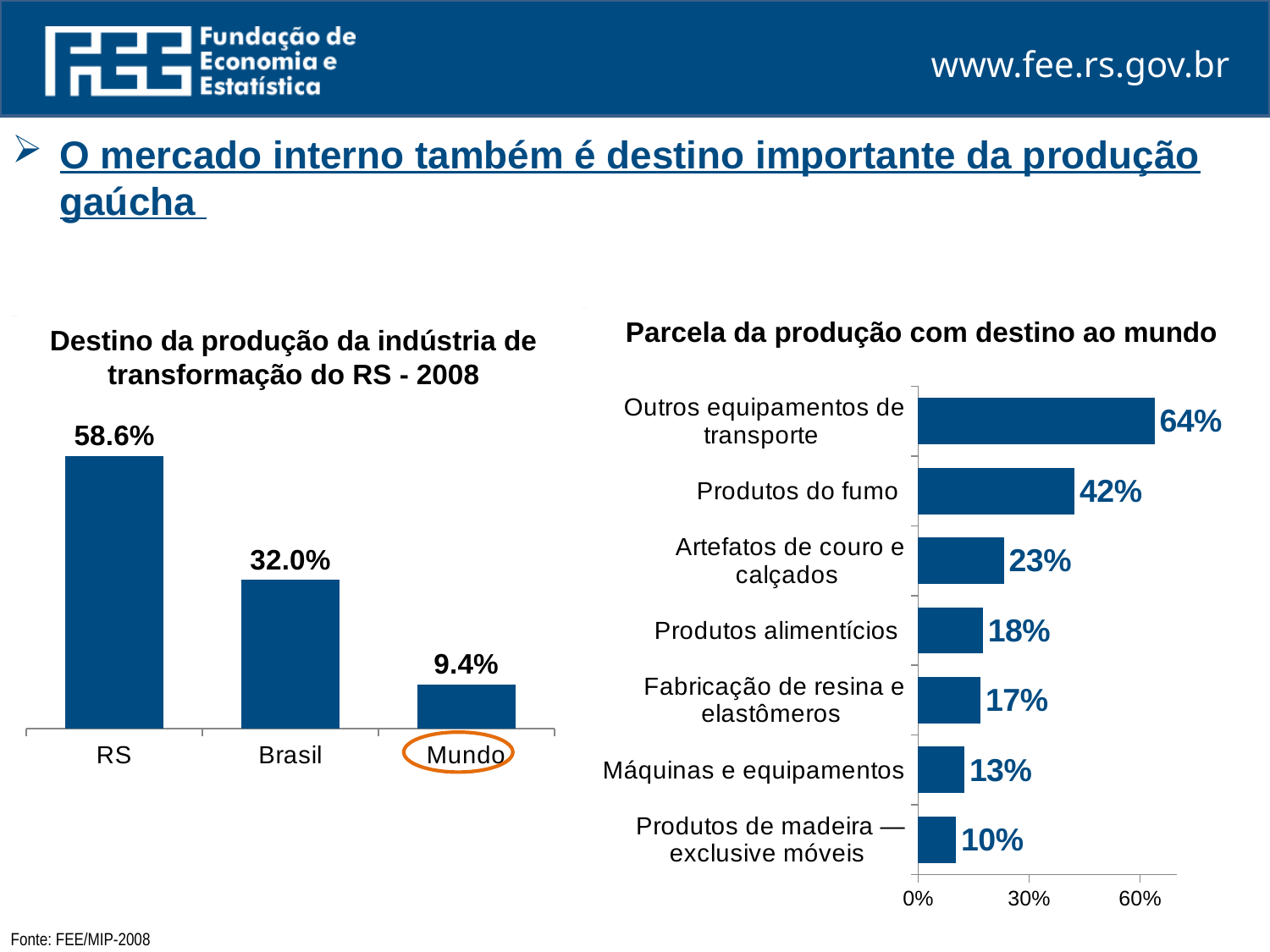
In the chart 'Parcela da produção com destino ao mundo', what is the difference between Outros equipamentos de transporte and Artefatos de couro e calçados? 41% In the chart 'Destino da produção da indústria de transformação do RS - 2008', what is the difference between the values for RS and Brasil? 26.6% In the chart 'Parcela da produção com destino ao mundo', how many categories are shown? 7 In the chart 'Parcela da produção com destino ao mundo', what is the value for Máquinas e equipamentos? 13% In the chart 'Destino da produção da indústria de transformação do RS - 2008', what is the value for Mundo? 9.4% What kind of chart is 'Parcela da produção com destino ao mundo'? Bar chart In the chart 'Destino da produção da indústria de transformação do RS - 2008', what is the value for RS? 58.6% In the chart 'Destino da produção da indústria de transformação do RS - 2008', how many categories are shown? 3 In the chart 'Parcela da produção com destino ao mundo', what is the value for Produtos do fumo? 42% In the chart 'Destino da produção da indústria de transformação do RS - 2008', which category has the lowest value? Mundo In the chart 'Parcela da produção com destino ao mundo', which is larger: Produtos alimentícios or Fabricação de resina e elastômeros? Produtos alimentícios In the chart 'Parcela da produção com destino ao mundo', which category has the highest value? Outros equipamentos de transporte